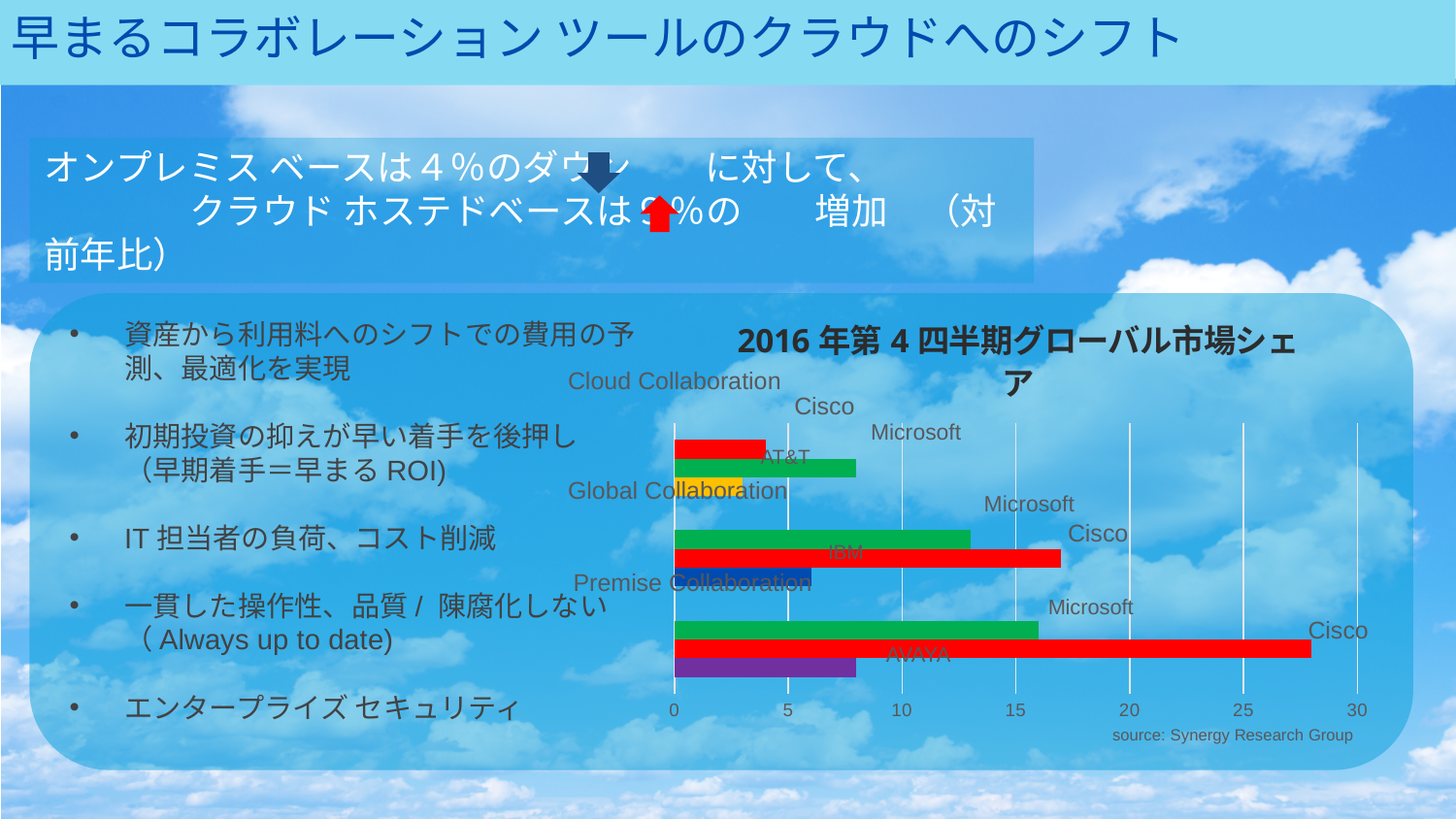
Is the value for Cisco in Premise Collaboration greater or less than 25? greater In the Global Collaboration category, which is larger, the value for Cisco or the value for IBM? Cisco What is the title of the chart? 2016年第4四半期グローバル市場シェア Is the value for AT&T in Cloud Collaboration greater or less than 5? less Which vendor has the longest bar in the Premise Collaboration category? Cisco What source is cited below the chart? Synergy Research Group How many categories are shown on the vertical axis of the chart? 3 Is the value for Microsoft in Premise Collaboration greater or less than 15? greater What kind of chart is shown on the slide? bar chart Which vendor has the longest bar in the Cloud Collaboration category? Microsoft